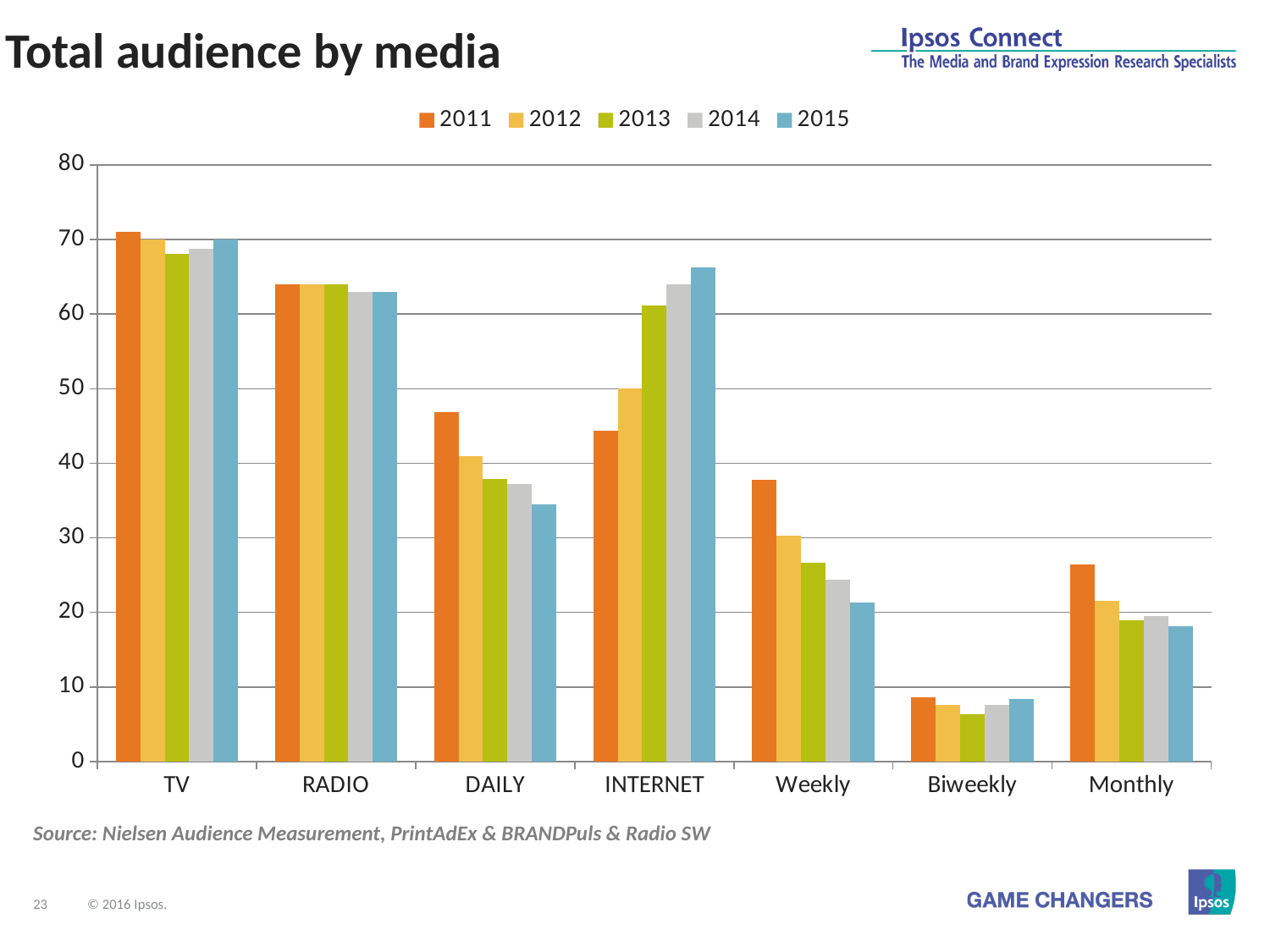
Is the value for DAILY in 2015 greater or less than 40? less Do the values for DAILY rise or fall from 2011 to 2015? Fall How many media categories are shown on the x axis? 7 Which media category has the highest audience values overall? TV Which media category has the lowest audience values overall? Biweekly Is the value for Biweekly in 2013 greater or less than 10? less Which is larger in 2015: the value for INTERNET or the value for DAILY? INTERNET How many series does the legend list? 5 Is the value for INTERNET in 2015 greater or less than 60? greater What kind of chart is shown on the slide? Bar chart For DAILY, which year has the highest value? 2011 For INTERNET, which year has the highest value? 2015